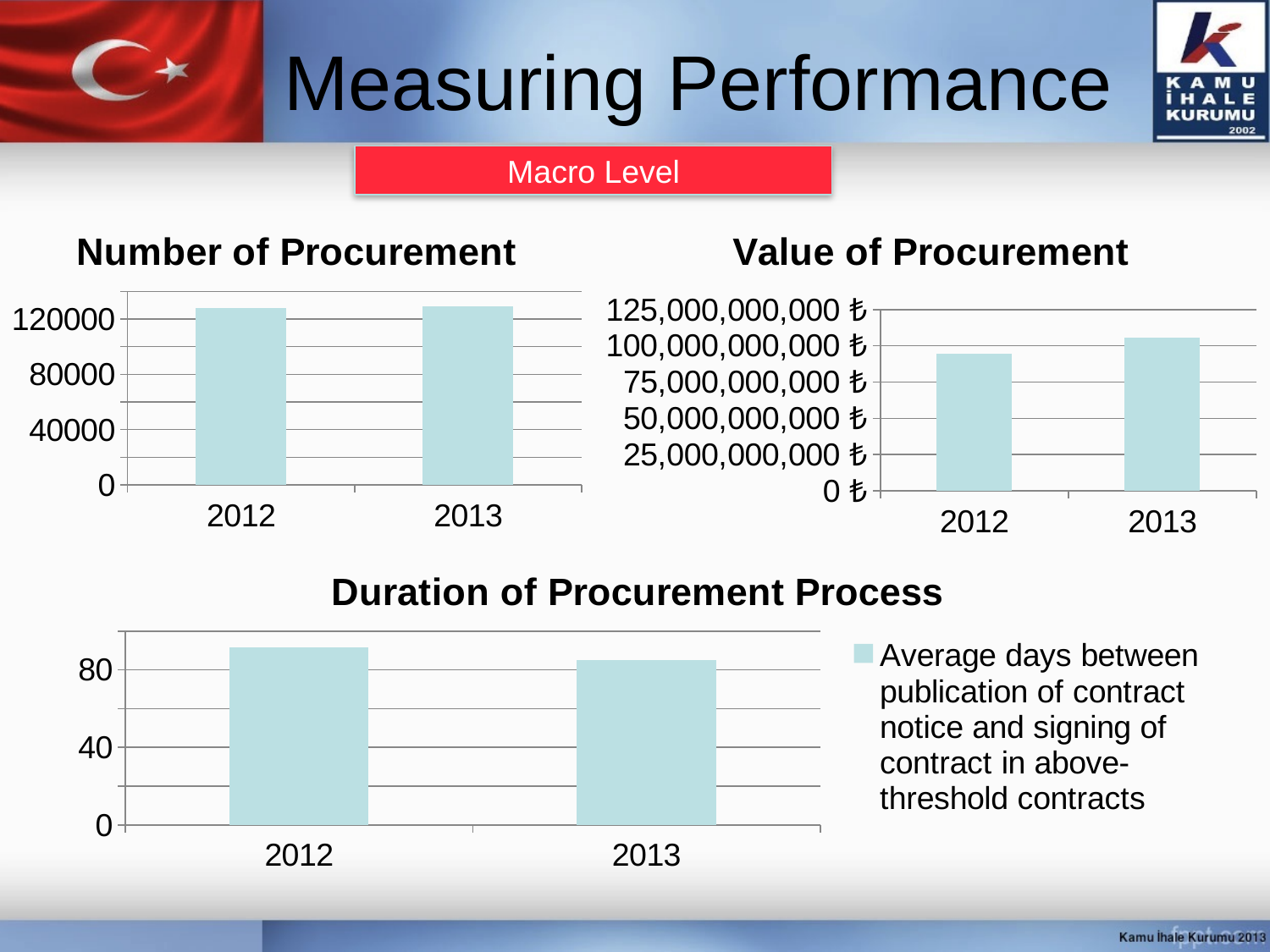
In the Value of Procurement chart, which year has the higher value? 2013 In the Duration of Procurement Process chart, is the value for 2012 greater or less than 80? greater In the Value of Procurement chart, do the values rise or fall from 2012 to 2013? rise In the Duration of Procurement Process chart, do the values rise or fall from 2012 to 2013? fall In the Number of Procurement chart, is the value for 2013 greater or less than 80000? greater In the Value of Procurement chart, is the value for 2013 greater or less than 100,000,000,000 ₺? greater What is the legend entry of the Duration of Procurement Process chart? Average days between publication of contract notice and signing of contract in above-threshold contracts How many categories are shown on the x axis of the Value of Procurement chart? 2 In the Duration of Procurement Process chart, which year has the lower value? 2013 What kind of chart is the Number of Procurement chart? bar chart